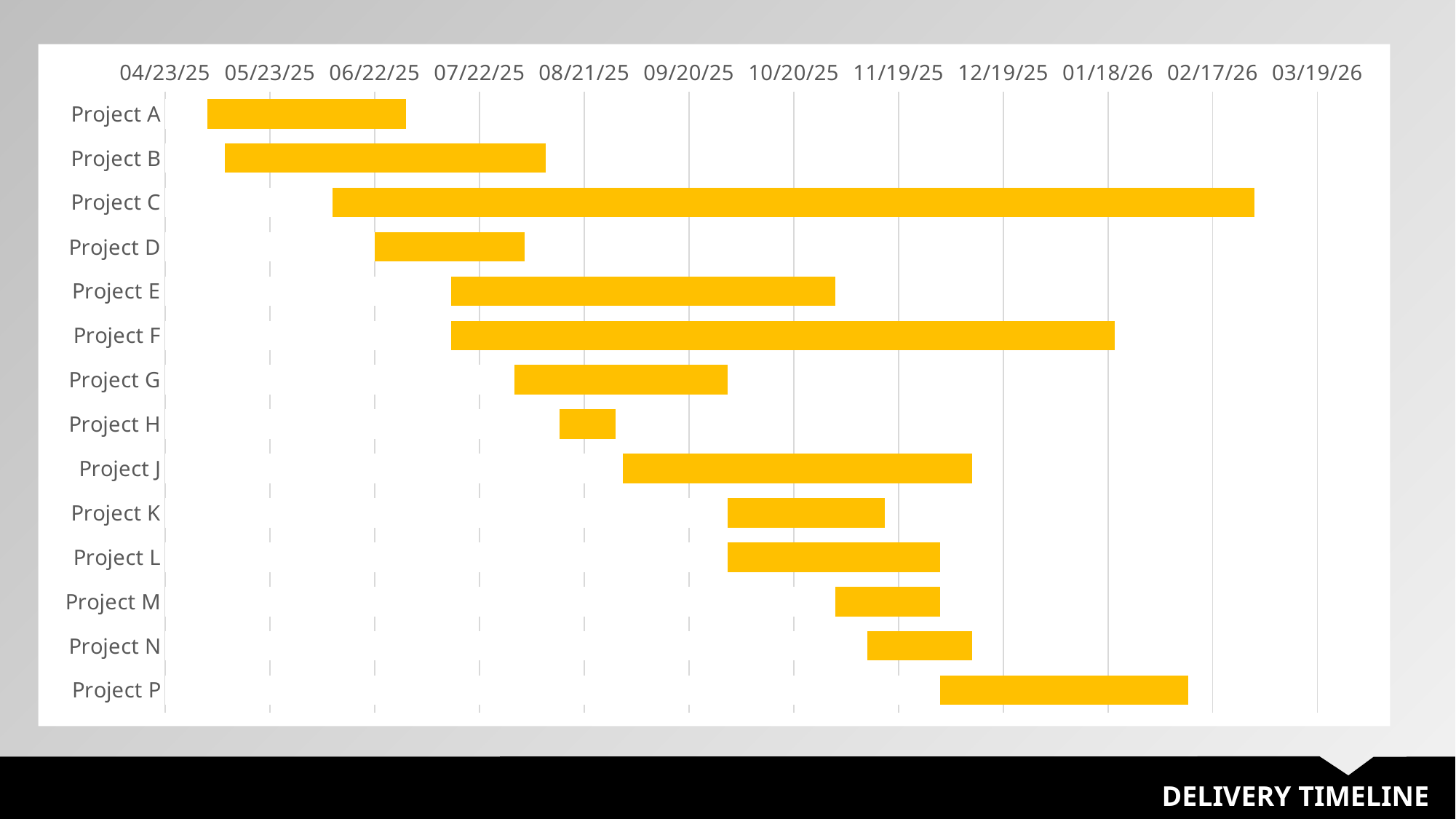
Does Project B end before or after 08/21/25? before Does Project C end before or after 02/17/26? after Which bar is longer, Project J or Project K? Project J How many projects are listed on the chart? 14 Which project starts earliest on the timeline? Project A Which project starts latest on the timeline? Project P Does Project H start before or after 07/22/25? after Which project has the shortest bar on the timeline? Project H What kind of chart is shown on the slide? Bar chart (Gantt chart) Which project has the longest bar on the timeline? Project C Which bar is longer, Project C or Project D? Project C What is the title shown at the bottom of the slide? DELIVERY TIMELINE